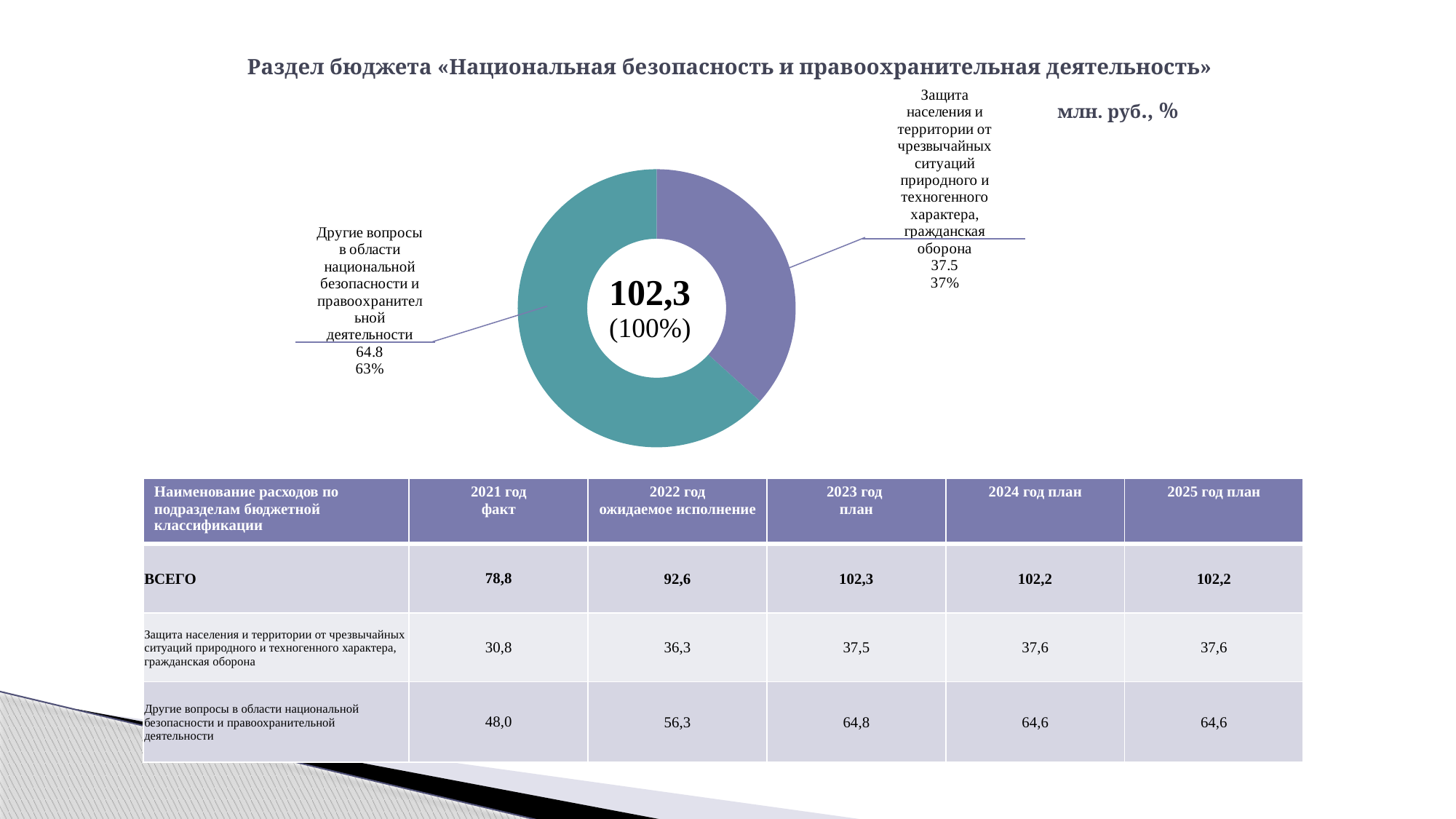
What units are indicated for the donut chart values? млн. руб., % What value is shown for «Другие вопросы в области национальной безопасности и правоохранительной деятельности» in the donut chart? 64.8 What share of the donut chart does «Защита населения и территории от чрезвычайных ситуаций природного и техногенного характера, гражданская оборона» represent? 37% How many slices does the donut chart have? 2 Which slice of the donut chart is the largest? Другие вопросы в области национальной безопасности и правоохранительной деятельности What kind of chart is shown on the slide? Pie (donut) chart Which is larger in the donut chart: «Защита населения...» or «Другие вопросы...»? Другие вопросы в области национальной безопасности и правоохранительной деятельности What value is shown for «Защита населения и территории от чрезвычайных ситуаций природного и техногенного характера, гражданская оборона» in the donut chart? 37.5 What is the difference between the two slice values in the donut chart (64.8 and 37.5)? 27.3 What share of the donut chart does «Другие вопросы в области национальной безопасности и правоохранительной деятельности» represent? 63% What total value is shown in the centre of the donut chart? 102,3 (100%) Which slice of the donut chart is the smallest? Защита населения и территории от чрезвычайных ситуаций природного и техногенного характера, гражданская оборона